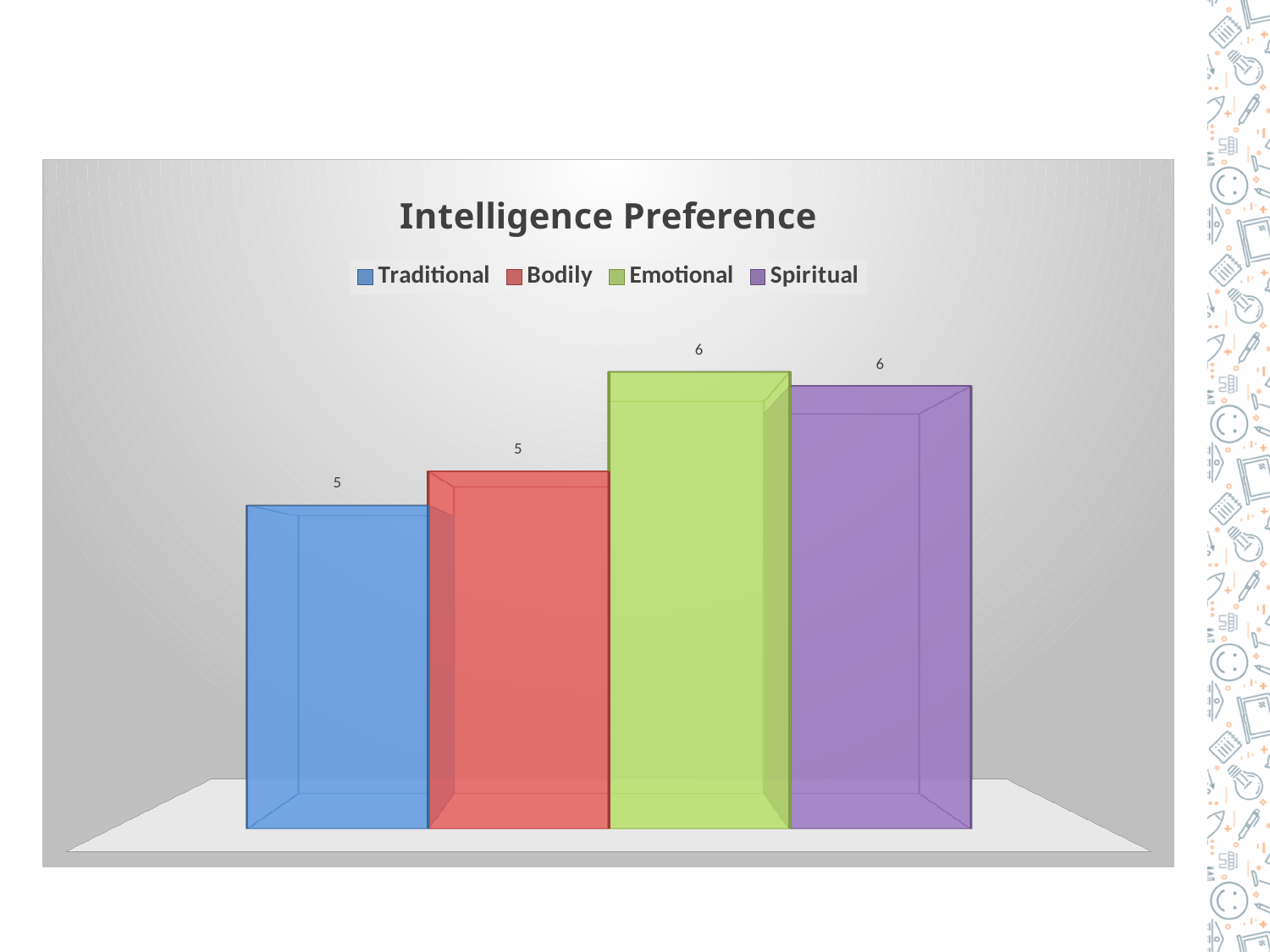
What is the difference between the Spiritual and Traditional values in the Intelligence Preference chart? 1 What kind of chart is shown on the slide? Bar chart What is the value for Spiritual in the Intelligence Preference chart? 6 How many series does the legend of the Intelligence Preference chart list? 4 What is the difference between the Emotional and Bodily values in the Intelligence Preference chart? 1 How many bars are plotted in the Intelligence Preference chart? 4 Which is larger in the Intelligence Preference chart, Bodily or Spiritual? Spiritual What is the value for Traditional in the Intelligence Preference chart? 5 What is the value for Bodily in the Intelligence Preference chart? 5 Which is larger in the Intelligence Preference chart, Emotional or Traditional? Emotional What is the value for Emotional in the Intelligence Preference chart? 6 What is the title of the chart on the slide? Intelligence Preference